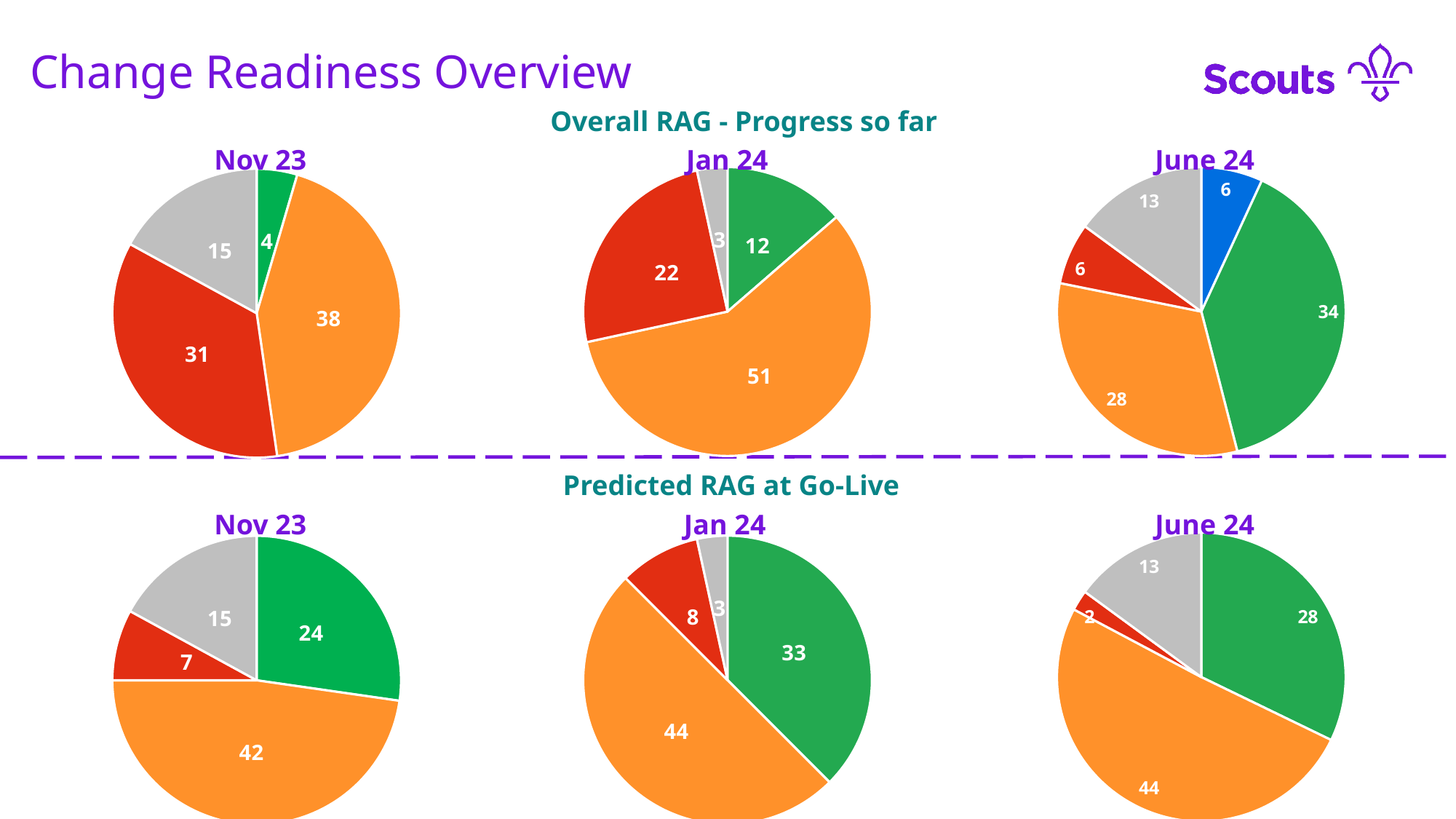
In the 'Overall RAG - Progress so far' Nov 23 pie chart, is the red slice or the orange slice larger? Orange How many pie charts are shown on the slide in total? 6 In the 'Overall RAG - Progress so far' June 24 pie chart, which colour slice has the largest value? Green How many slices does the 'Predicted RAG at Go-Live' Nov 23 pie chart have? 4 In the 'Overall RAG - Progress so far' June 24 pie chart, what value is shown on the blue slice? 6 In the 'Predicted RAG at Go-Live' June 24 pie chart, what value is shown on the red slice? 2 What type of chart is used for the 'Predicted RAG at Go-Live' Jan 24 chart? Pie chart In the 'Overall RAG - Progress so far' Jan 24 pie chart, what value is shown on the red slice? 22 In the 'Predicted RAG at Go-Live' Jan 24 pie chart, what is the difference between the orange slice and the green slice? 11 In the 'Overall RAG - Progress so far' Nov 23 pie chart, which colour slice has the smallest value? Green In the 'Overall RAG - Progress so far' Nov 23 pie chart, what value is shown on the orange slice? 38 How many slices does the 'Overall RAG - Progress so far' June 24 pie chart have? 5